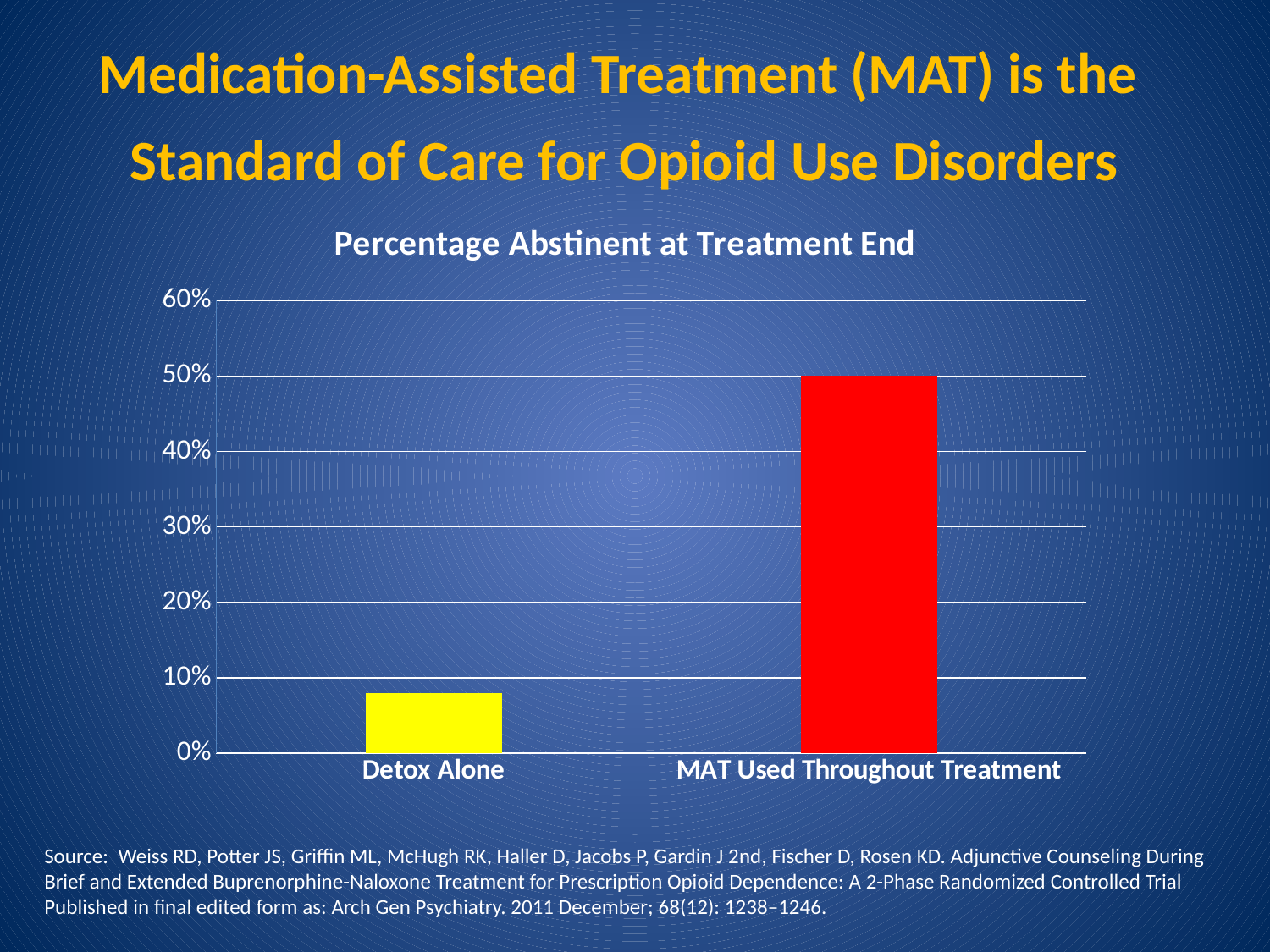
Which is larger, the value for Detox Alone or the value for MAT Used Throughout Treatment? MAT Used Throughout Treatment Is the value for MAT Used Throughout Treatment greater or less than 40%? greater What is the highest value shown on the y axis of the chart? 60% Which category has the lowest percentage abstinent at treatment end? Detox Alone What kind of chart is shown on the slide? bar chart What is the title of the chart? Percentage Abstinent at Treatment End Do the values rise or fall moving from Detox Alone to MAT Used Throughout Treatment along the x axis? rise How many categories are shown on the x axis of the chart? 2 Is the value for Detox Alone greater or less than 10%? less What is the percentage abstinent at treatment end for MAT Used Throughout Treatment? 50% Which category has the highest percentage abstinent at treatment end? MAT Used Throughout Treatment